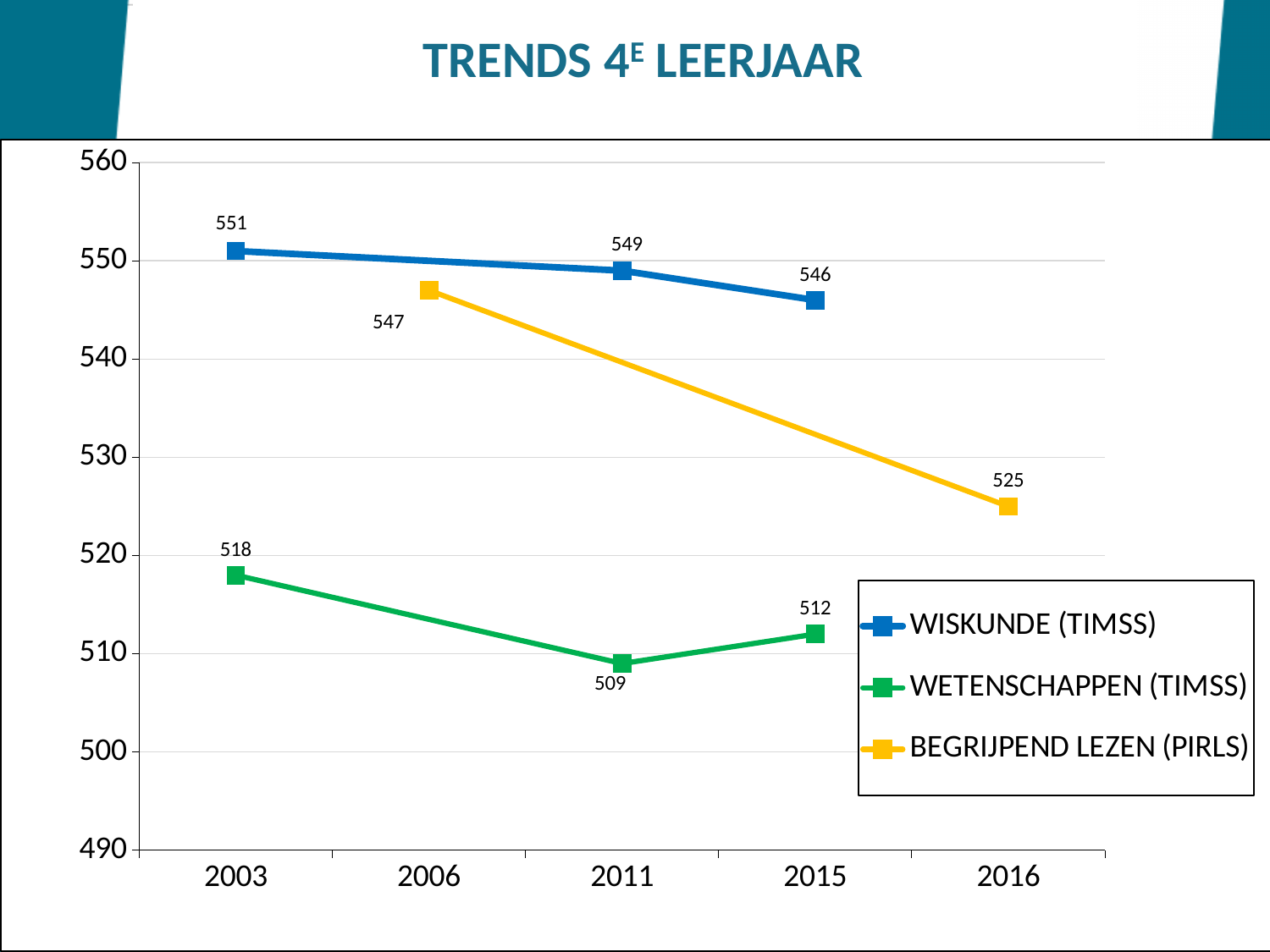
Does the WISKUNDE (TIMSS) series rise or fall from 2003 to 2015? fall What is the value for BEGRIJPEND LEZEN (PIRLS) in 2016? 525 In which year is WETENSCHAPPEN (TIMSS) lowest? 2011 What is the difference between the BEGRIJPEND LEZEN (PIRLS) value in 2006 and in 2016? 22 Which is larger in 2015: WISKUNDE (TIMSS) or WETENSCHAPPEN (TIMSS)? WISKUNDE (TIMSS) What is the value for WISKUNDE (TIMSS) in 2003? 551 What kind of chart is shown on the slide? line chart What is the difference between the WISKUNDE (TIMSS) value in 2003 and in 2015? 5 What is the value for BEGRIJPEND LEZEN (PIRLS) in 2006? 547 How many series does the legend list? 3 In which year is WISKUNDE (TIMSS) highest? 2003 What is the value for WETENSCHAPPEN (TIMSS) in 2011? 509